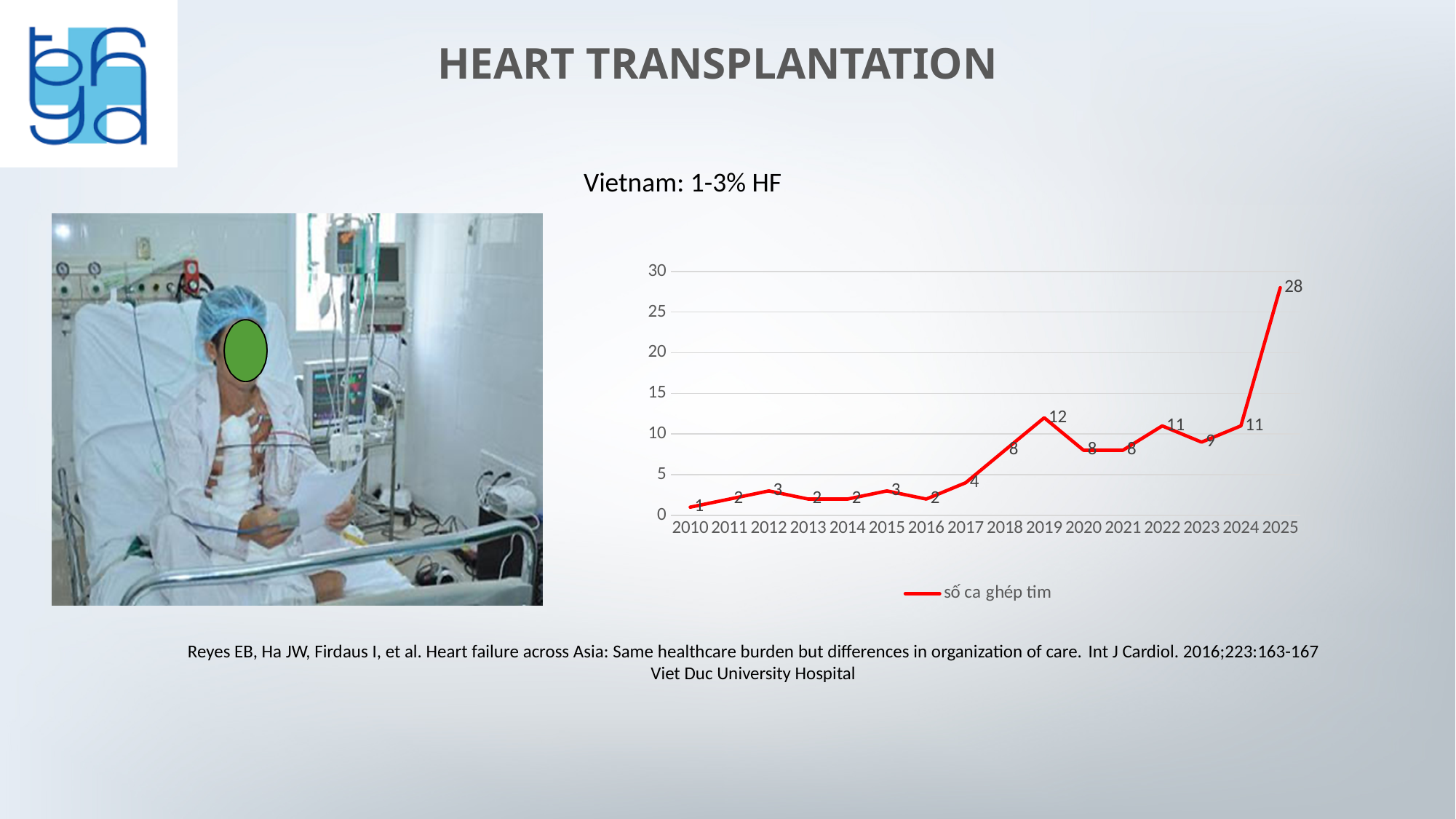
What type of chart is shown on the slide? line chart What is the value for 2019? 12 What is the difference between the values for 2025 and 2024? 17 What is the value for 2010? 1 How many years are plotted on the x axis? 16 Which year has the lowest value? 2010 How many series does the legend list? 1 Which year has the highest value? 2025 What is the value for 2025? 28 What is the name of the series shown in the legend? số ca ghép tim What is the value for 2023? 9 Which is larger, the value for 2019 or the value for 2022? 2019